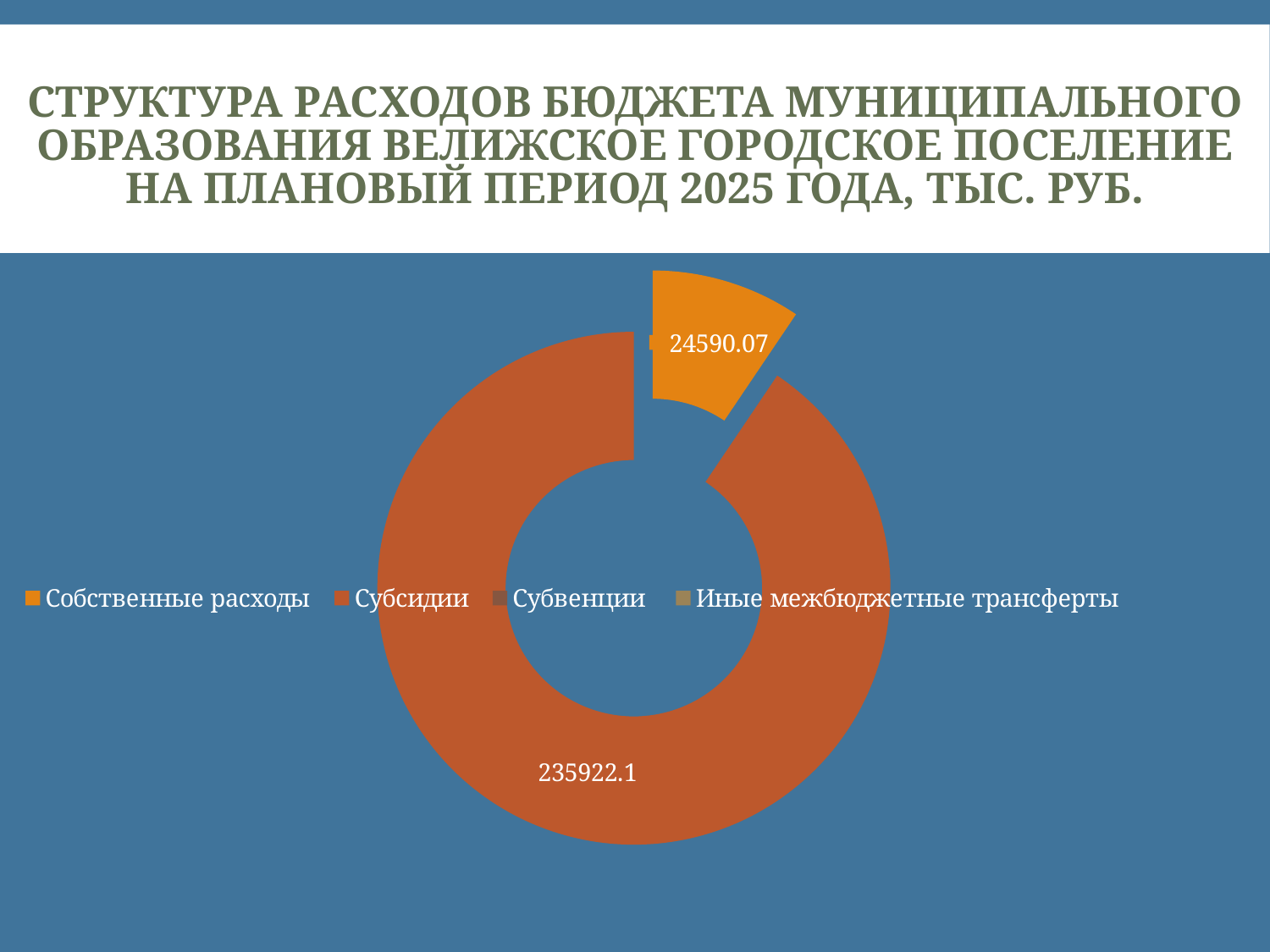
Which category has the largest slice on the chart? Субсидии What unit of measurement is stated in the chart title? тыс. руб. What value is shown for Собственные расходы on the chart? 24590.07 What colour is the slice for Собственные расходы? Orange What kind of chart is shown on the slide? Doughnut chart Which is larger: the value for Субсидии or the value for Собственные расходы? Субсидии What is the total of the two values labelled on the chart? 260512.17 What is the difference between the values for Субсидии and Собственные расходы? 211332.03 Which of the two labelled slices is the smallest? Собственные расходы What value is shown for Субсидии on the chart? 235922.1 How many categories does the legend list? 4 How many slices with data labels are visible on the chart? 2